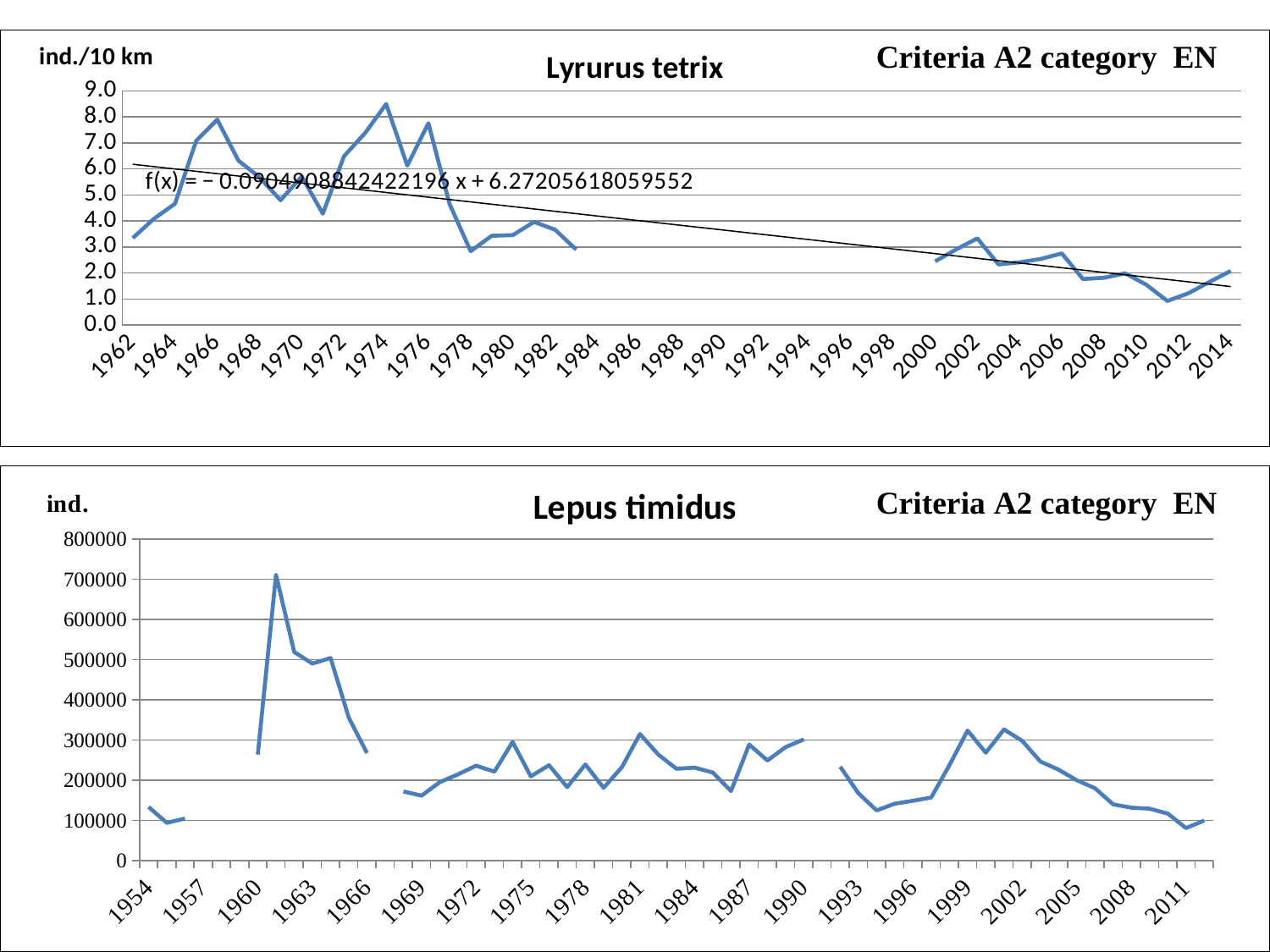
What kind of chart is the Lyrurus tetrix chart? line chart In the Lyrurus tetrix chart, which year has the larger value, 1966 or 2002? 1966 In the Lyrurus tetrix chart, do the values overall rise or fall from 1962 to 2014? fall What is the y-axis unit label on the Lyrurus tetrix chart? ind./10 km In the Lyrurus tetrix chart, is the value for 2011 greater or less than 2.0? less What kind of chart is the Lepus timidus chart? line chart In the Lyrurus tetrix chart, is the value for 1974 greater or less than 8.0? greater In the Lyrurus tetrix chart, which year has the highest value? 1974 In the Lepus timidus chart, is the value for 1961 greater or less than 600000? greater In the Lyrurus tetrix chart, which year has the lowest value? 2011 In the Lepus timidus chart, which year has the highest value? 1961